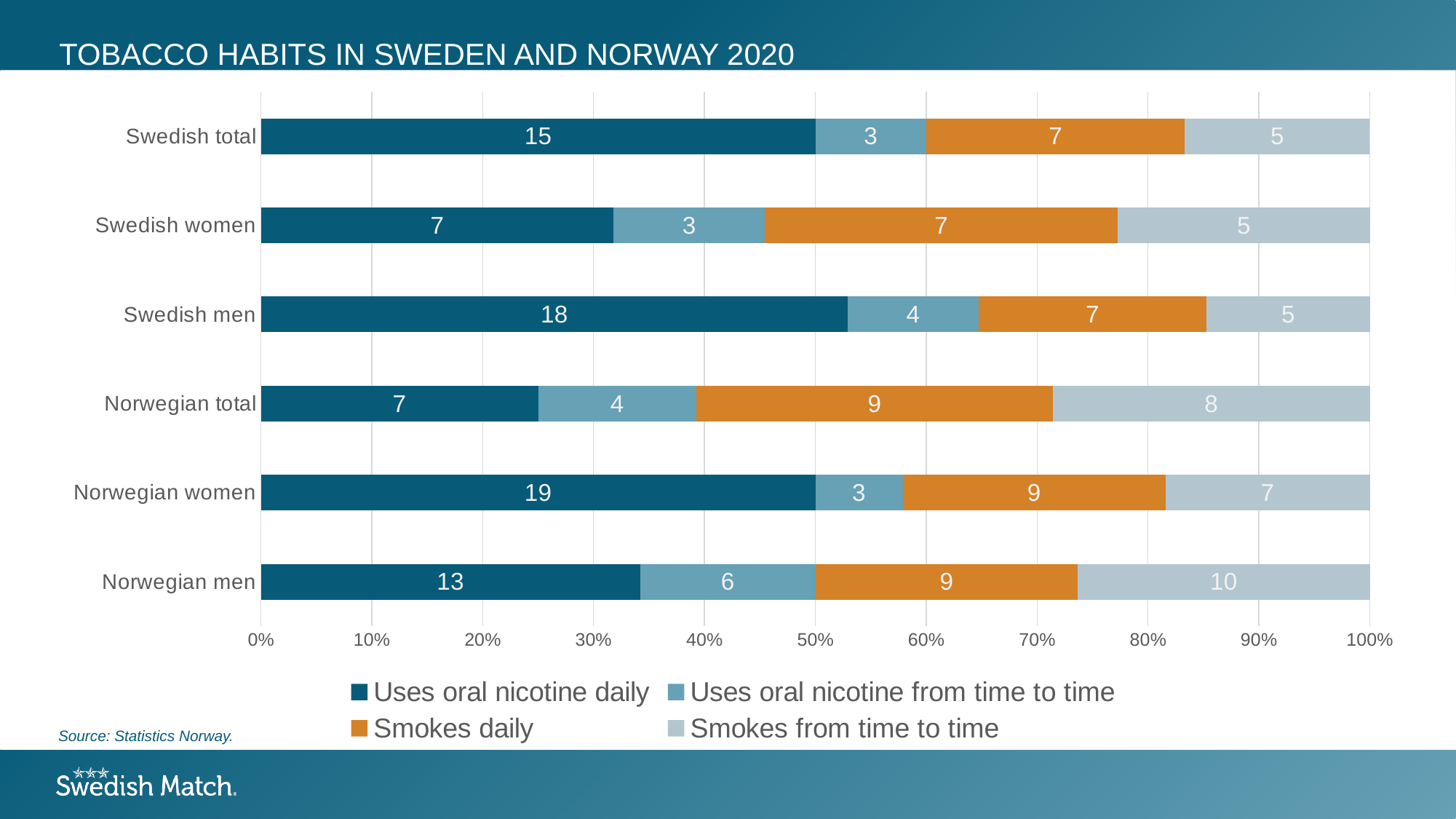
What is the value for 'Smokes daily' for Norwegian total? 9 What is the sum of the four labelled values for Norwegian men? 38 Which category has the highest value for 'Uses oral nicotine daily'? Norwegian women What is the value for 'Uses oral nicotine daily' for Swedish men? 18 Which category has the highest value for 'Uses oral nicotine from time to time'? Norwegian men How many series does the legend list? 4 What is the title of the chart? TOBACCO HABITS IN SWEDEN AND NORWAY 2020 What is the value for 'Smokes from time to time' for Norwegian men? 10 What is the difference between the 'Uses oral nicotine daily' values for Swedish men and Swedish women? 11 What kind of chart is shown on the slide? Stacked bar chart How many categories are shown on the vertical axis of the chart? 6 Which is larger, the 'Uses oral nicotine daily' value for Swedish total or for Norwegian total? Swedish total